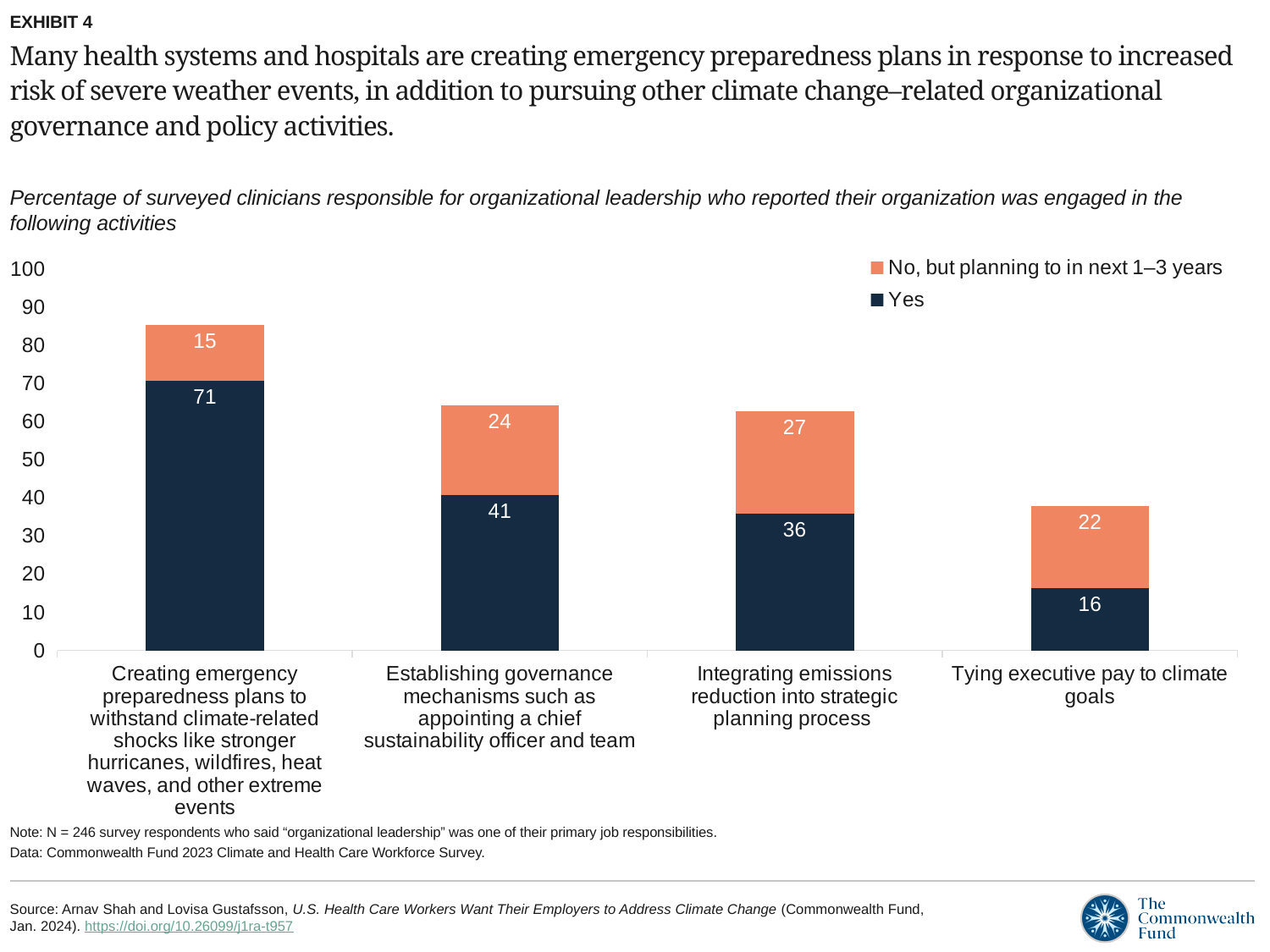
Which activity has the highest 'Yes' value? Creating emergency preparedness plans to withstand climate-related shocks like stronger hurricanes, wildfires, heat waves, and other extreme events Which is larger: the 'No, but planning to' value for establishing governance mechanisms or for integrating emissions reduction into strategic planning? Integrating emissions reduction into strategic planning process Which activity has the lowest 'Yes' value? Tying executive pay to climate goals What is the 'No, but planning to in next 1–3 years' value for tying executive pay to climate goals? 22 What kind of chart is shown on the slide? Stacked bar chart What is the 'Yes' value for integrating emissions reduction into strategic planning process? 36 How many activity categories are shown on the x axis? 4 What percentage of clinicians reported 'Yes' for creating emergency preparedness plans to withstand climate-related shocks? 71 What is the total of the stacked bar for tying executive pay to climate goals? 38 What is the difference between the 'Yes' values for creating emergency preparedness plans and establishing governance mechanisms? 30 How many series does the legend list? 2 What is the total of the stacked bar for establishing governance mechanisms such as appointing a chief sustainability officer and team? 65